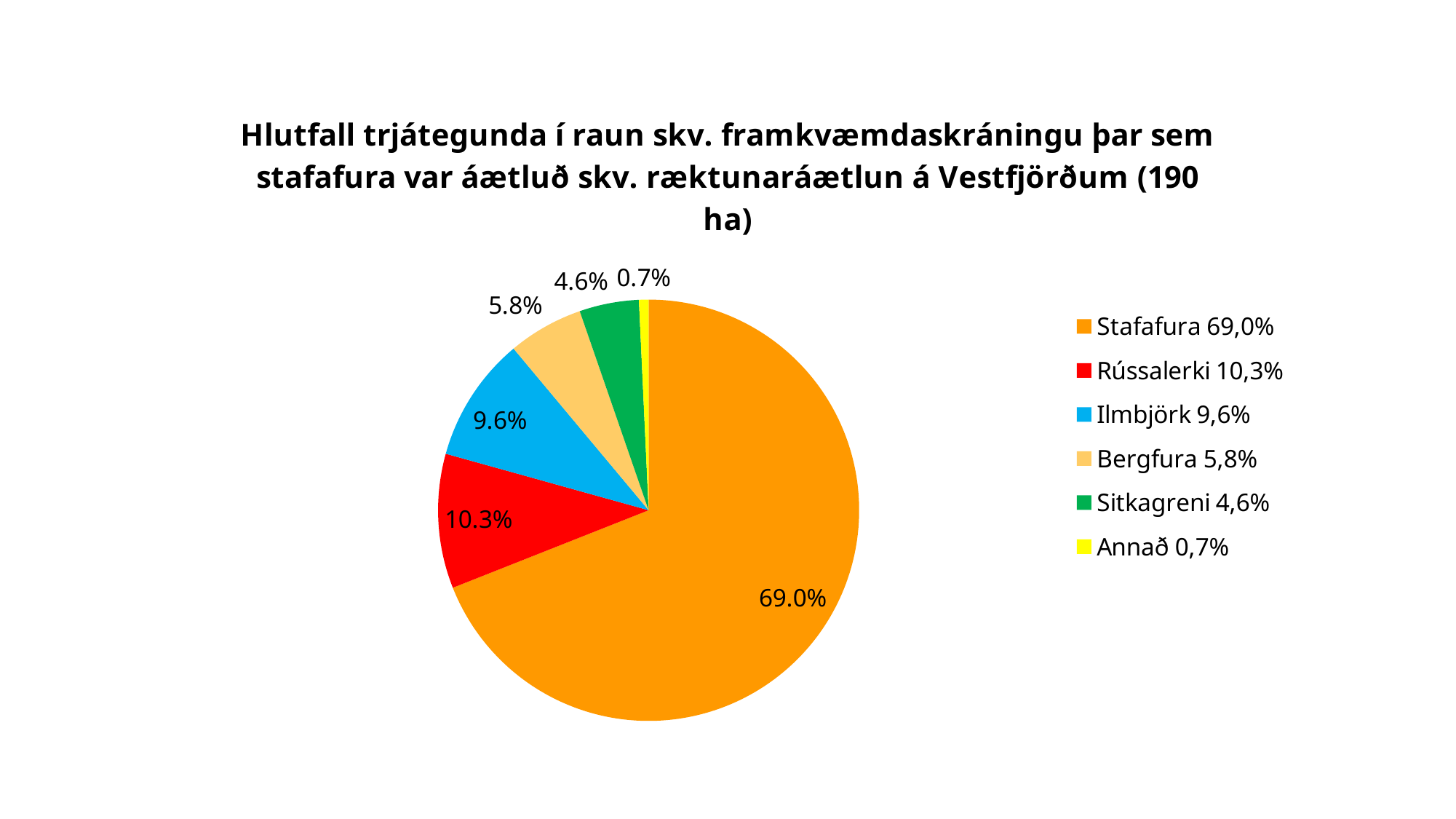
What is the value shown for Sitkagreni? 4.6% What colour is the slice for Ilmbjörk? blue What is the difference in percentage points between Stafafura and Rússalerki? 58.7 What is the value shown for Bergfura? 5.8% What share of the pie does Stafafura have? 69.0% How many categories does the pie chart show? 6 Which is larger, the slice for Bergfura or the slice for Sitkagreni? Bergfura Which category has the largest slice of the pie? Stafafura What kind of chart is shown on the slide? pie chart Which category has the smallest slice of the pie? Annað What is the value shown for Rússalerki? 10.3% What is the value shown for Ilmbjörk? 9.6%